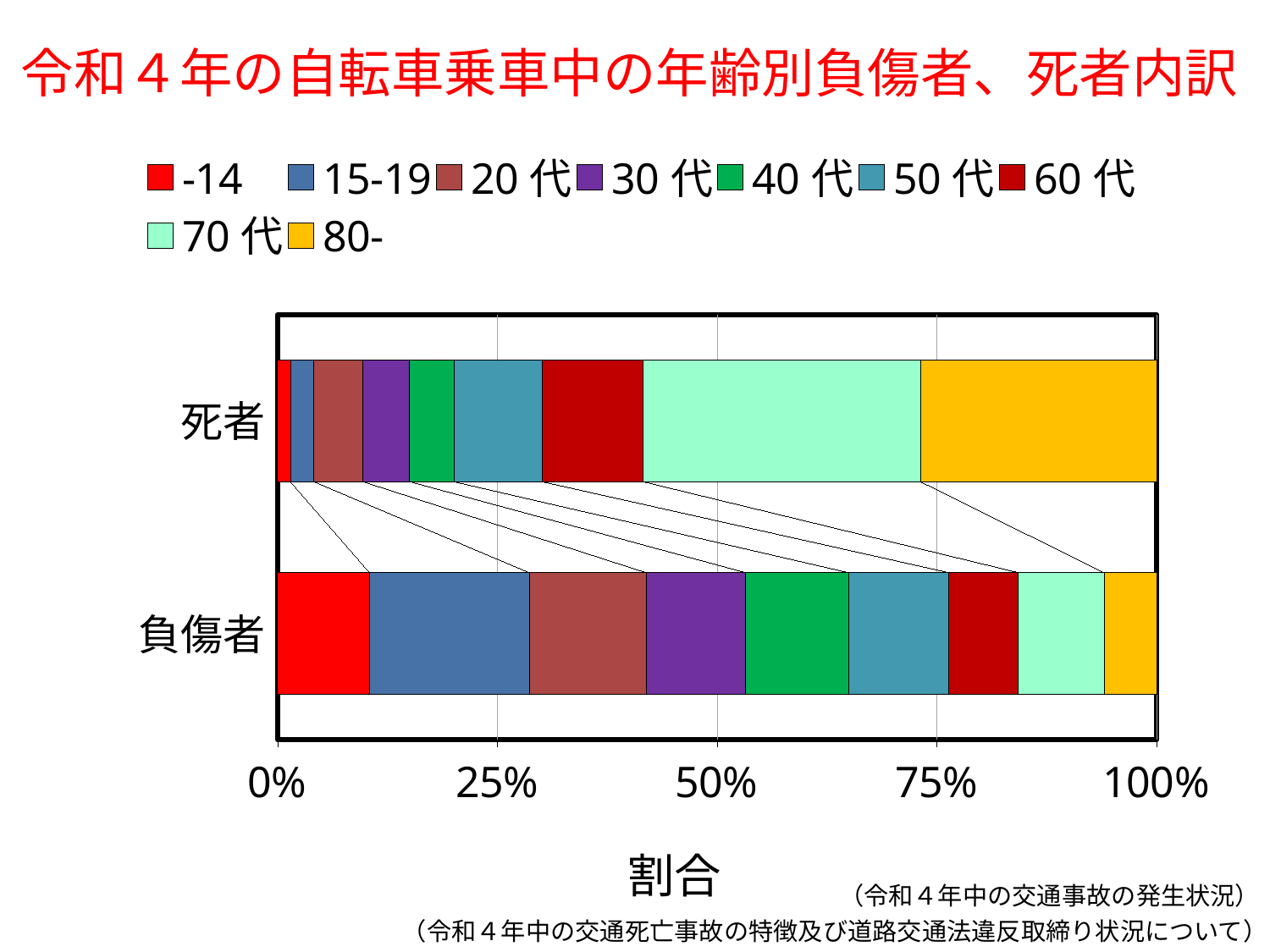
Which age group has the smallest share in the 負傷者 bar? 80- Which age group has the smallest share in the 死者 bar? -14 Is the share of 80- larger in the 死者 bar or the 負傷者 bar? 死者 What is the title of the chart? 令和４年の自転車乗車中の年齢別負傷者、死者内訳 Which age group has the largest share in the 死者 bar? 70 代 What kind of chart is shown on the slide? Stacked bar chart How many series does the legend list? 9 How many categories (bars) are plotted on the chart? 2 Is the share of 70 代 in the 死者 bar greater or less than 25%? greater What is the label of the horizontal axis? 割合 Is the share of -14 larger in the 死者 bar or the 負傷者 bar? 負傷者 Which age group has the largest share in the 負傷者 bar? 15-19